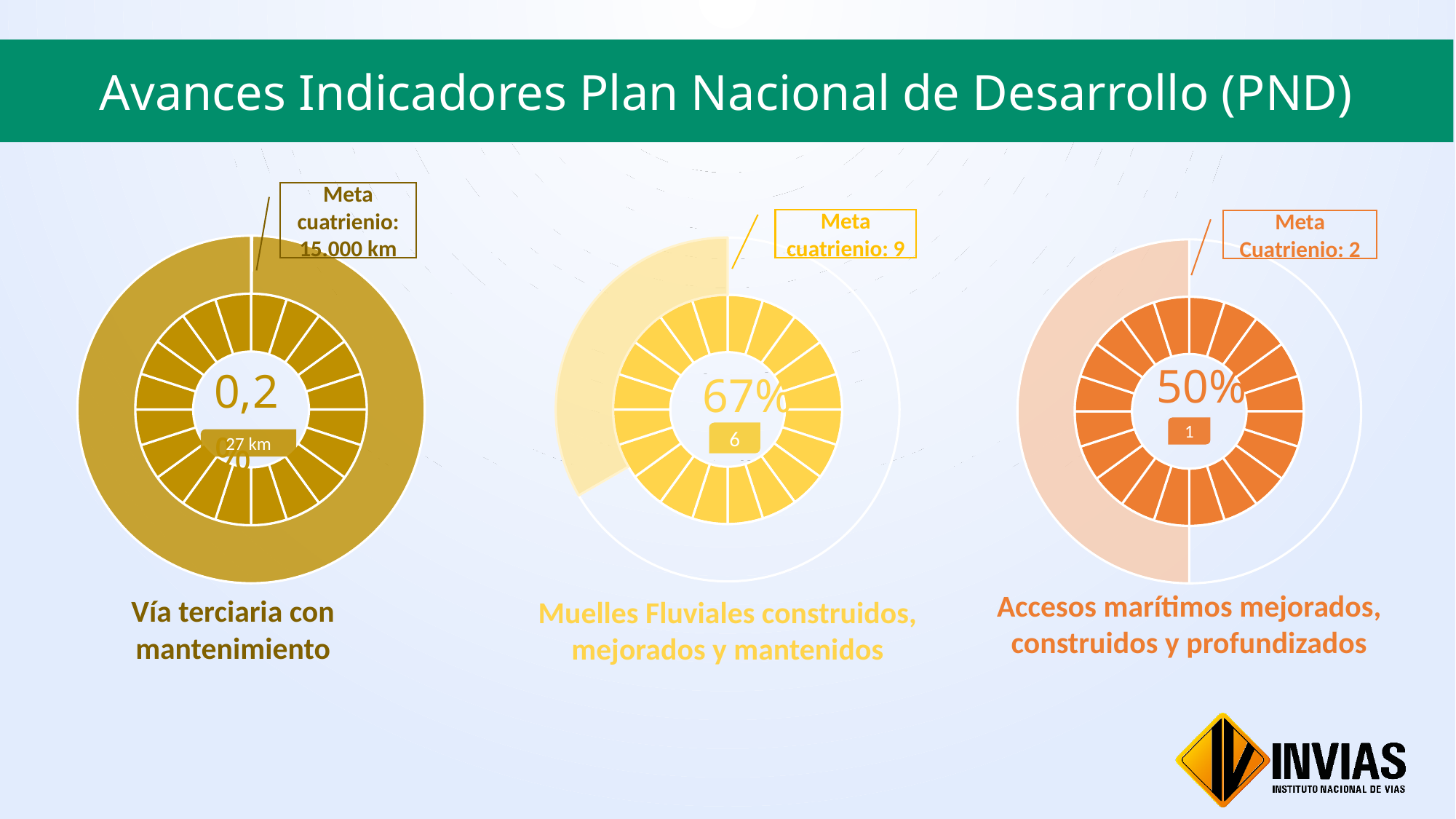
What is the 'Meta cuatrienio' for the 'Vía terciaria con mantenimiento' chart? 15.000 km What is the 'Meta cuatrienio' for the 'Muelles Fluviales construidos, mejorados y mantenidos' chart? 9 Which chart shows a higher completion percentage, 'Muelles Fluviales' or 'Accesos marítimos'? Muelles Fluviales How many indicator charts are shown on the slide? 3 What is the title of the slide? Avances Indicadores Plan Nacional de Desarrollo (PND) How many km are shown as achieved in the 'Vía terciaria con mantenimiento' chart? 27 km What number is shown in the small box below the percentage in the 'Muelles Fluviales' chart? 6 What percentage is shown in the centre of the 'Accesos marítimos mejorados, construidos y profundizados' chart? 50% In the 'Muelles Fluviales' chart, how many more units are needed to reach the Meta cuatrienio of 9 from the 6 achieved? 3 What is the 'Meta Cuatrienio' for the 'Accesos marítimos mejorados, construidos y profundizados' chart? 2 What number is shown in the small box below the percentage in the 'Accesos marítimos' chart? 1 What percentage is shown in the centre of the 'Muelles Fluviales construidos, mejorados y mantenidos' chart? 67%